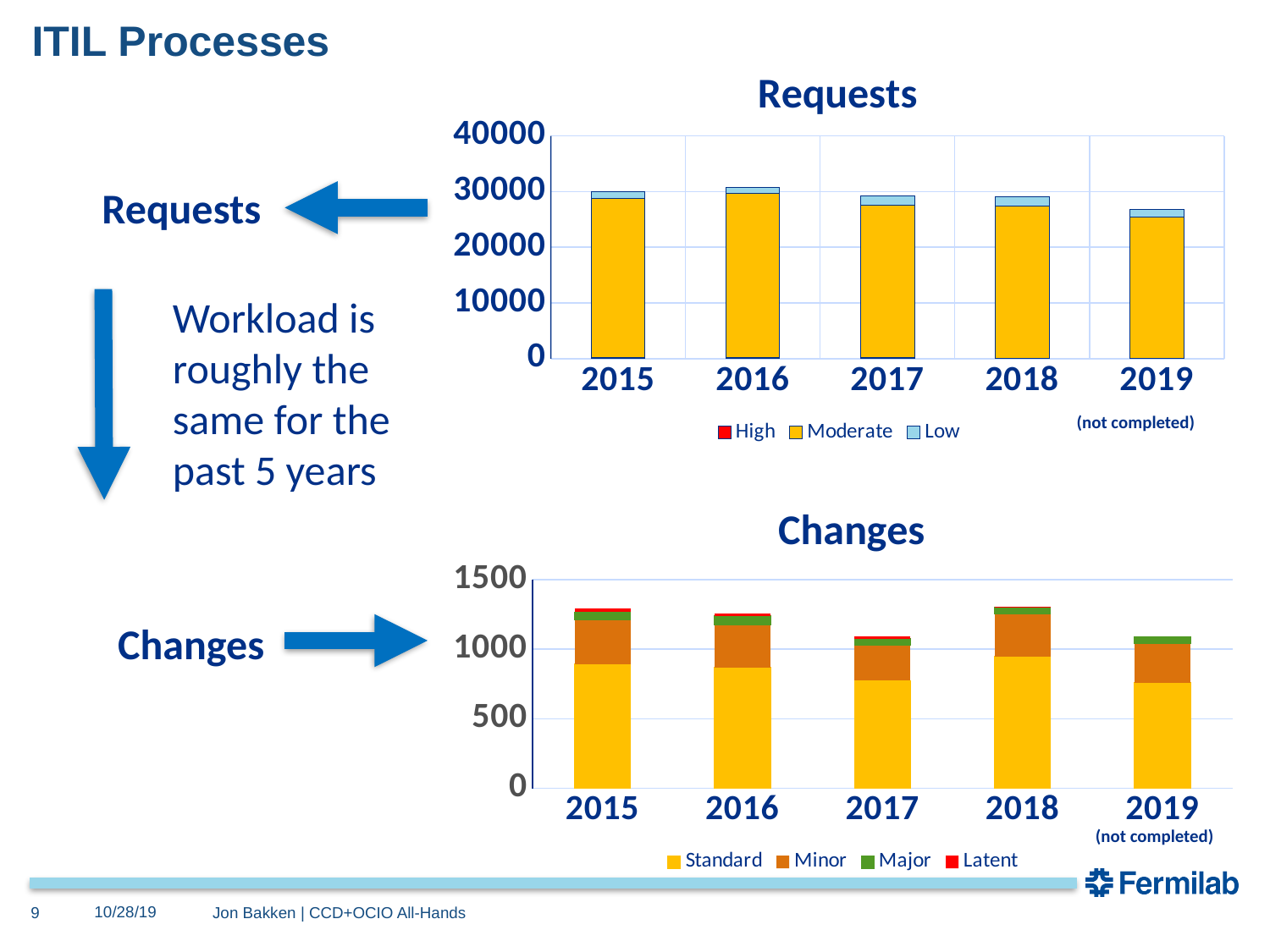
In the Requests chart, is the total for 2015 greater or less than 20000? greater In the Changes chart, is the total for 2018 greater or less than 1000? greater In the Requests chart, do total requests rise or fall from 2016 to 2019? fall In the Requests chart, which year has the lowest total requests? 2019 How many years are shown on the x axis of the Changes chart? 5 Which series in the Changes chart is shown in green? Major How many series does the legend of the Changes chart list? 4 What kind of chart is the Requests chart? stacked bar chart In the Requests chart, is the total for 2016 greater or less than 40000? less In the Changes chart, which is larger, the total for 2018 or the total for 2017? 2018 How many series does the legend of the Requests chart list? 3